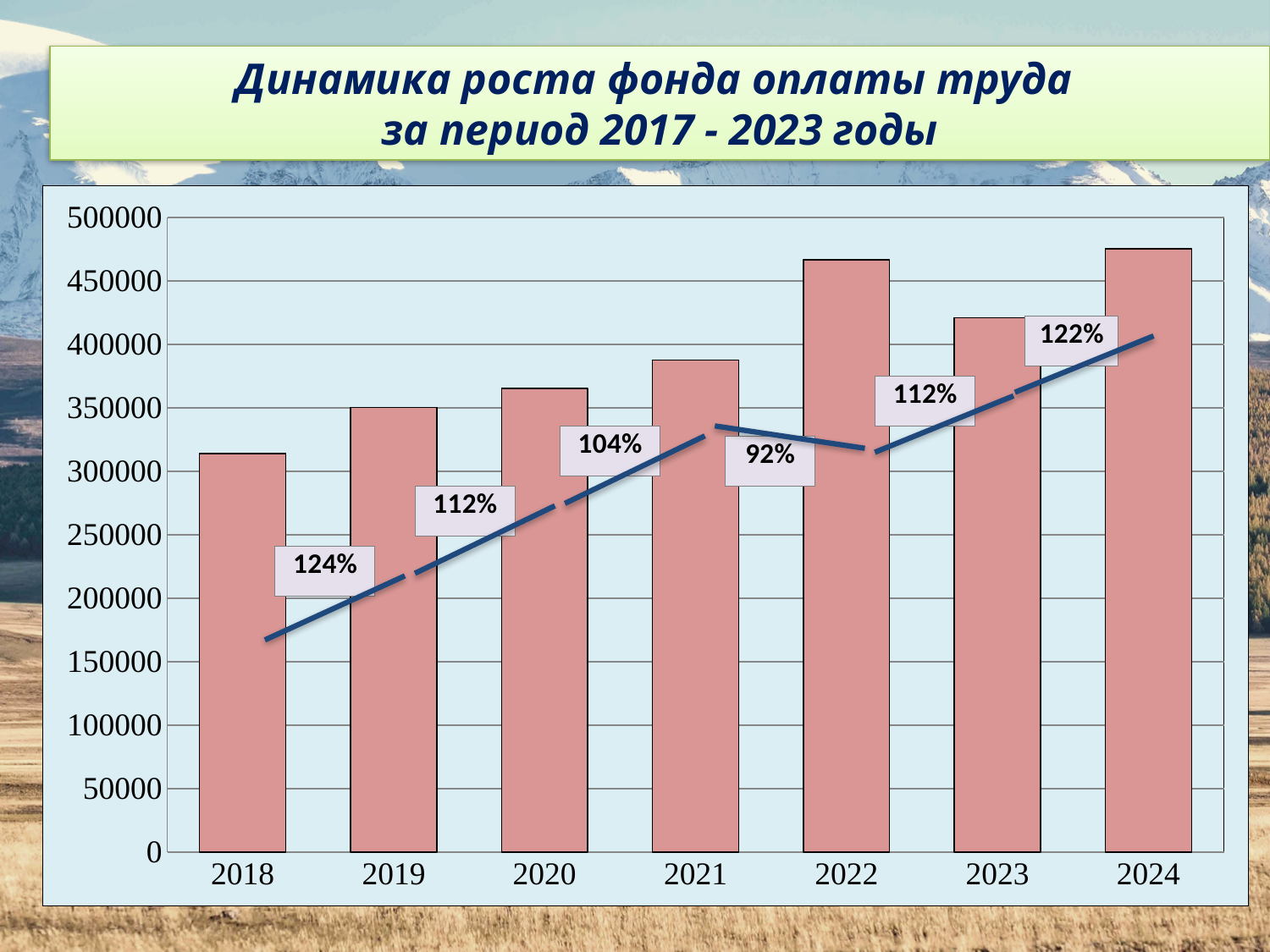
What kind of chart is shown on the slide? bar chart with a line What is the title of the chart? Динамика роста фонда оплаты труда за период 2017 - 2023 годы Which year has the lowest bar? 2018 How many years (bars) are shown on the x axis? 7 Is the value for 2021 greater or less than 400000? less What is the highest percentage label shown on the line? 124% Is the value for 2023 greater or less than 400000? greater Is the value for 2018 greater or less than 300000? greater Which bar is taller, 2020 or 2021? 2021 What is the lowest percentage label shown on the line? 92% Which bar is taller, 2022 or 2023? 2022